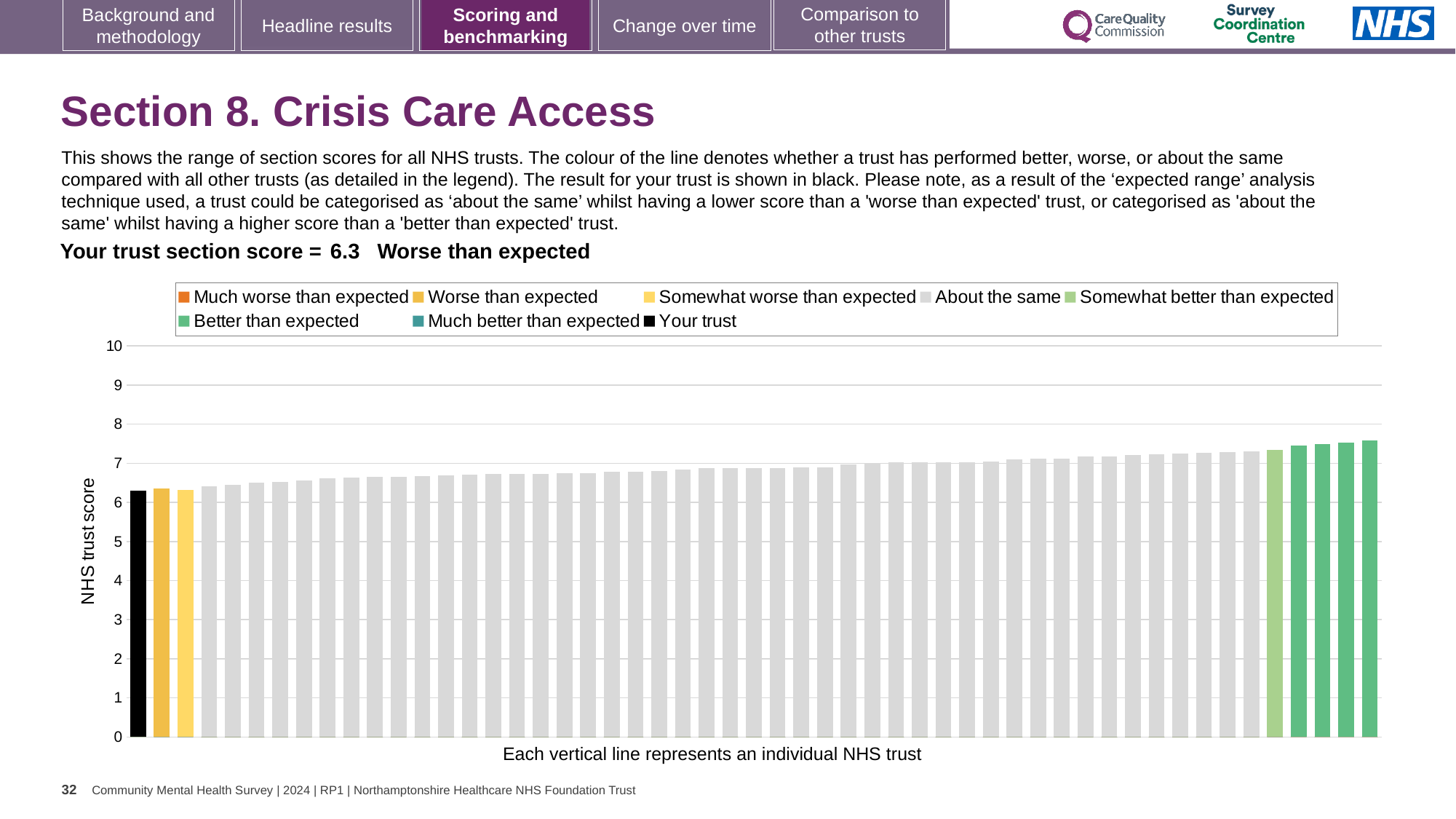
Do the bar values rise or fall from left to right along the x axis? rise What is the label of the vertical axis? NHS trust score Is the value of the black bar (your trust) greater or less than 7? less How many entries does the chart legend list? 8 Is the value of the tallest bar on the chart greater or less than 8? less Which bar is taller: the black bar for your trust or the rightmost bar? the rightmost bar What colour is used for the bar representing your trust? black Is the value of the shortest bar on the chart greater or less than 6? greater What kind of chart is shown on the slide? bar chart What is the section score for your trust shown on the slide? 6.3 How is your trust's section score categorised compared with other trusts? Worse than expected